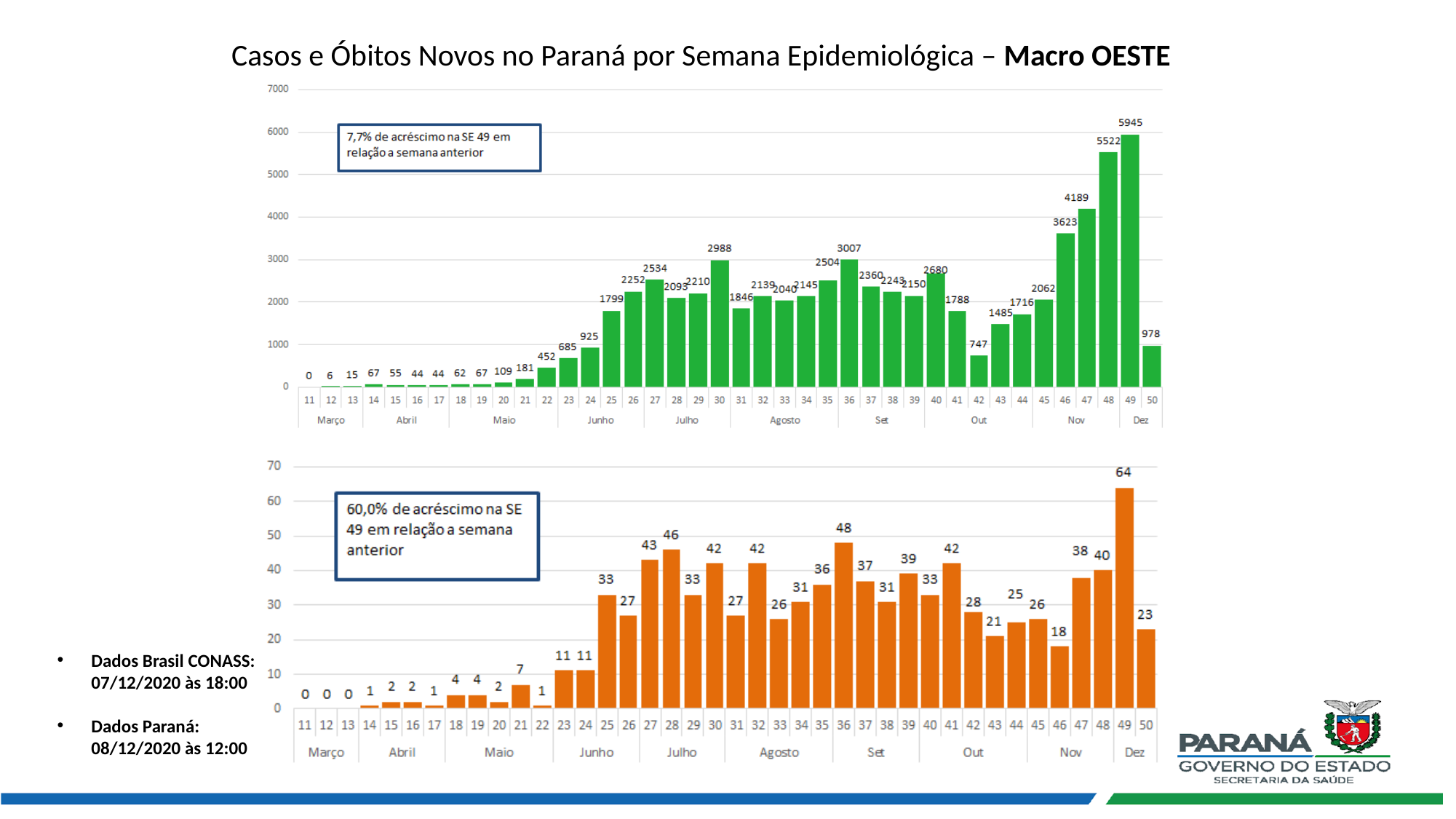
In the top chart, what is the difference between the values for week 49 and week 48? 423 In the top chart, what is the value for week 36? 3007 How many weeks are plotted in the top chart? 40 In the bottom chart, which is larger, the value for week 36 or the value for week 41? week 36 What kind of chart is the bottom chart? bar chart In the bottom chart, what is the value for week 28? 46 In the bottom chart, which week has the highest value? 49 In the top chart, which is larger, the value for week 30 or the value for week 36? week 36 In the bottom chart, what is the difference between the values for week 49 and week 48? 24 In the top chart, which week has the highest value? 49 In the top chart, what is the value for week 49? 5945 In the top chart, what is the value for week 42? 747